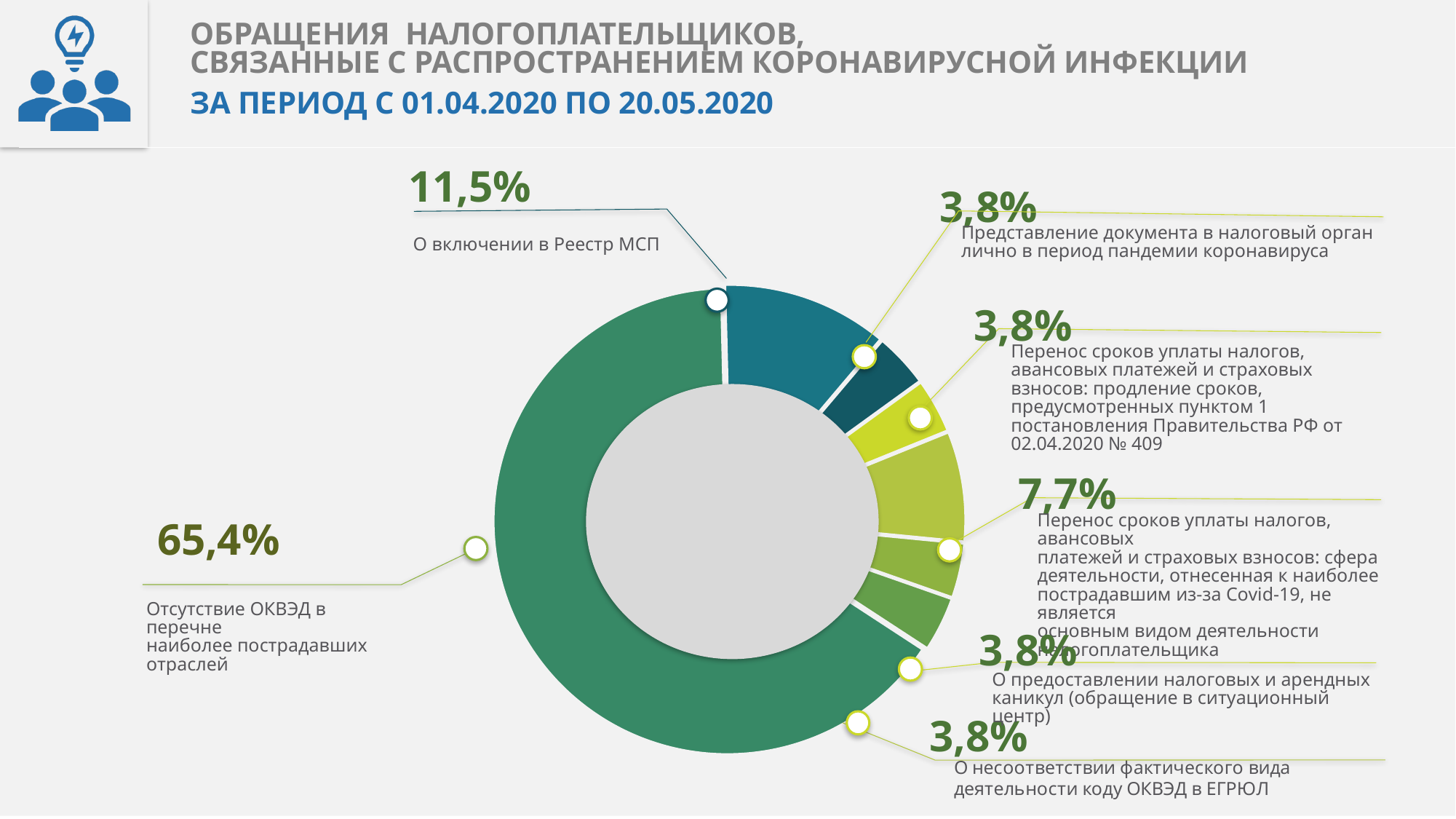
What kind of chart is shown on the slide? Donut (pie) chart What share of requests concerned the provision of tax and rent holidays (О предоставлении налоговых и арендных каникул)? 3,8% How many segments does the chart have? 7 Which category accounts for the largest share of requests? Отсутствие ОКВЭД в перечне наиболее пострадавших отраслей What share of requests concerned deferral of tax payments where the activity affected by Covid-19 is not the taxpayer's main activity? 7,7% What is the difference in percentage points between the share for absence of OKVED in the list of affected industries (65,4%) and the share for inclusion in the SME register (11,5%)? 53,9 Which is larger: the share for inclusion in the SME register or the share for deferral of tax payments where the affected activity is not the main activity? Inclusion in the SME register (11,5%) What share of requests concerned a mismatch between the actual type of activity and the OKVED code in the EGRUL? 3,8% What share of taxpayer requests concerned the absence of an OKVED code in the list of most affected industries (Отсутствие ОКВЭД в перечне наиболее пострадавших отраслей)? 65,4% What is the smallest share shown on the chart? 3,8% What share of requests concerned inclusion in the SME register (О включении в Реестр МСП)? 11,5% What period does the chart cover, according to the slide title? С 01.04.2020 по 20.05.2020